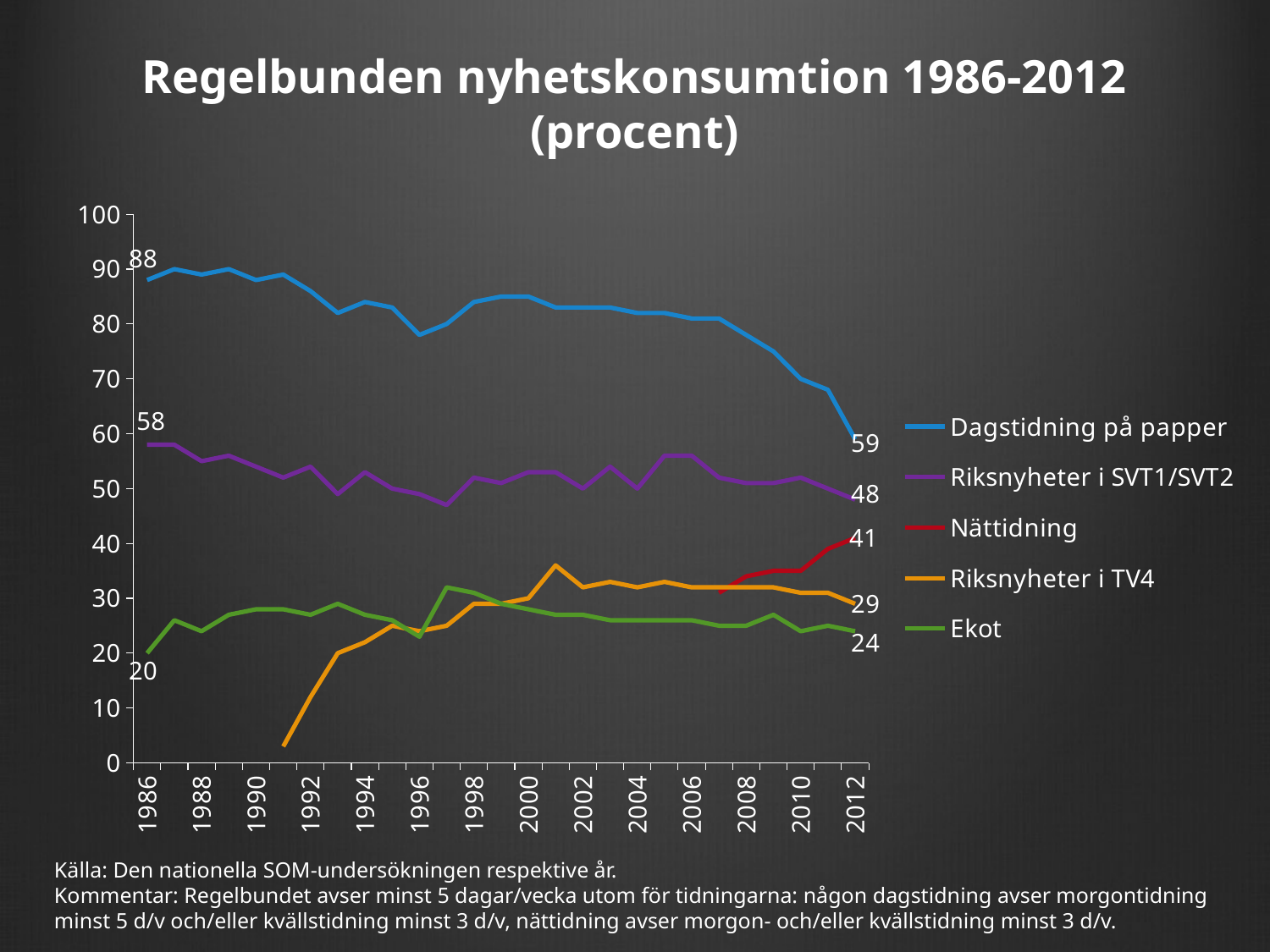
What is the value for Nättidning in 2012? 41 What is the value for Dagstidning på papper in 1986? 88 By how much did the value for Dagstidning på papper fall between 1986 and 2012? 29 Which series has the highest value in 2012? Dagstidning på papper Does the value for Dagstidning på papper rise or fall from 1986 to 2012? fall What type of chart is shown on the slide? line chart What is the difference between Riksnyheter i TV4 and Ekot in 2012? 5 What is the value for Riksnyheter i SVT1/SVT2 in 2012? 48 What is the value for Dagstidning på papper in 2012? 59 What is the value for Ekot in 1986? 20 Is the value for Riksnyheter i TV4 in 1991 greater or less than 10? less How many series does the legend list? 5